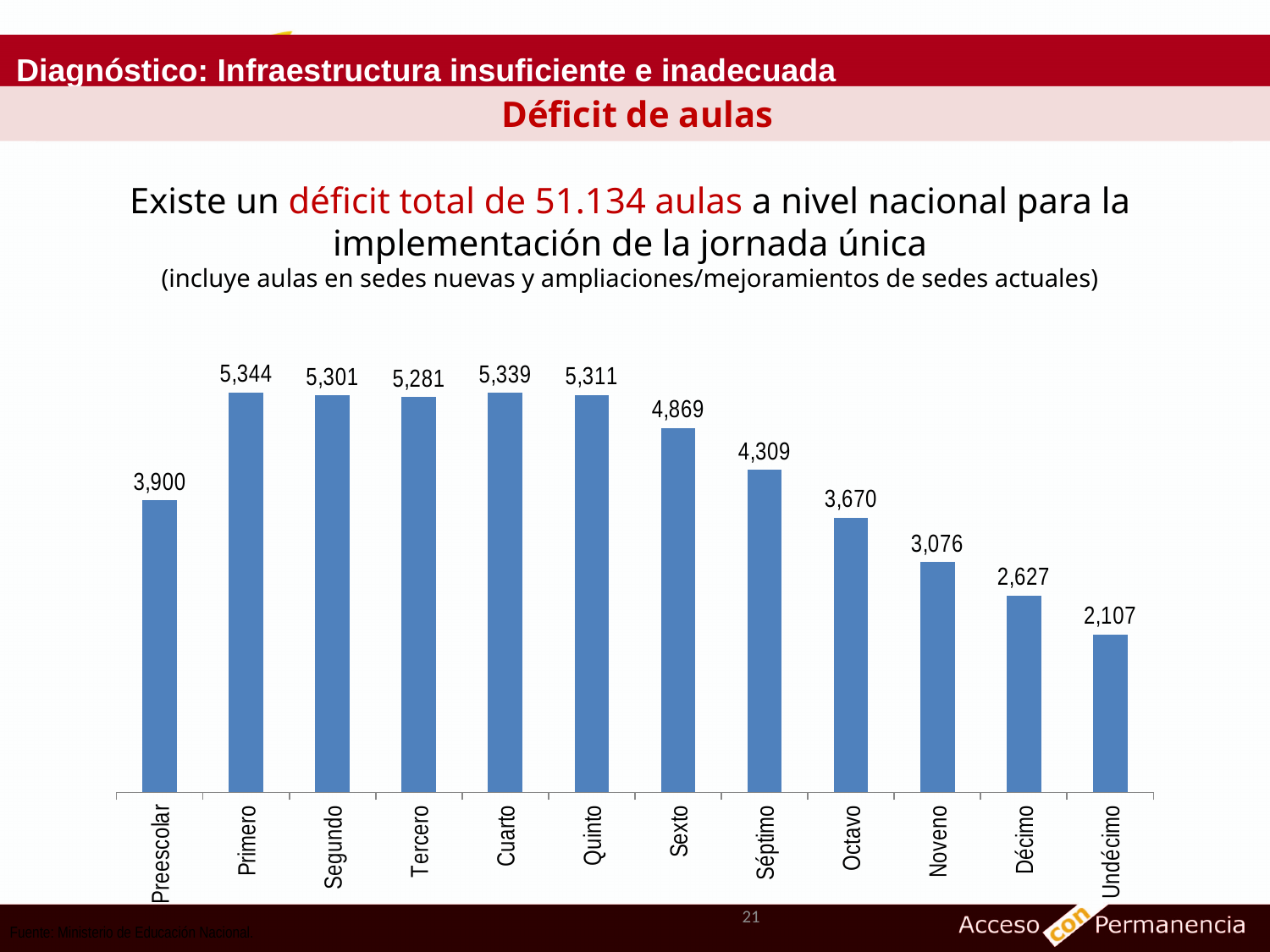
Which category has the lowest value? Undécimo Which is larger, the value for Preescolar or the value for Séptimo? Séptimo Which is larger, the value for Octavo or the value for Décimo? Octavo What is the value for Noveno? 3,076 What is the value for Undécimo? 2,107 What is the difference between the values for Preescolar and Undécimo? 1,793 What is the value for Sexto? 4,869 What is the difference between the values for Sexto and Séptimo? 560 What kind of chart is shown on the slide? Bar chart How many categories are shown on the x axis? 12 From Quinto to Undécimo, do the values rise or fall along the x axis? Fall What is the value for Preescolar? 3,900